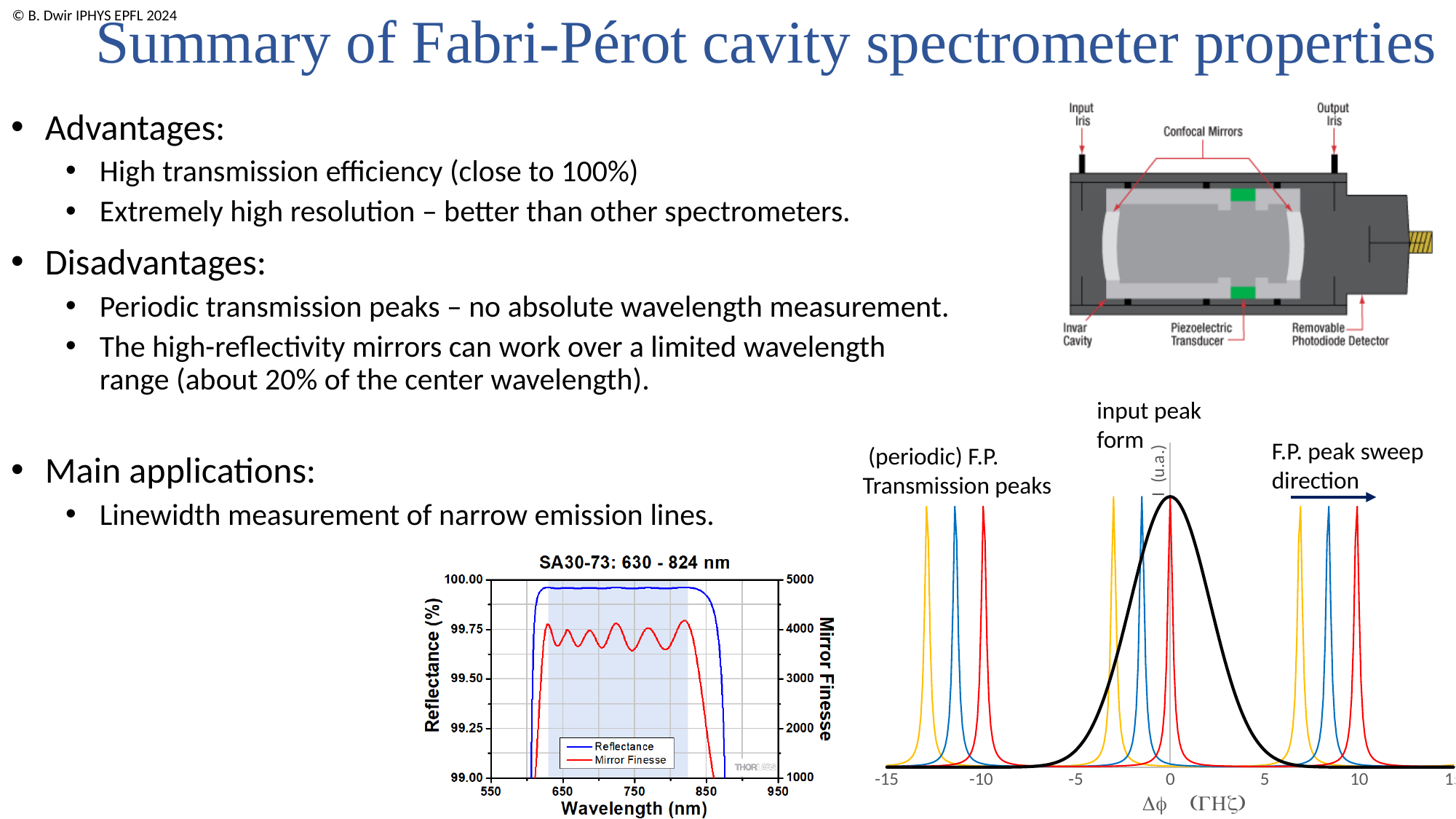
What is the x-axis label of the SA30-73: 630 - 824 nm chart? Wavelength (nm) In the SA30-73: 630 - 824 nm chart, is the reflectance at 900 nm greater or less than 99.25%? less What are the two legend entries in the SA30-73: 630 - 824 nm chart? Reflectance and Mirror Finesse In the periodic F.P. transmission peaks chart on the right, what is the lowest Δφ tick shown on the x axis? -15 In the periodic F.P. transmission peaks chart on the right, how many red peaks are shown? 3 What kind of chart is the SA30-73: 630 - 824 nm chart? line chart In the SA30-73: 630 - 824 nm chart, is the reflectance at 750 nm greater or less than 99.75%? greater How many series does the legend of the SA30-73: 630 - 824 nm chart list? 2 In the SA30-73: 630 - 824 nm chart, is the reflectance at 650 nm greater or less than 99.50%? greater What kind of chart is the periodic F.P. transmission peaks chart on the right of the slide? line chart In the chart of periodic F.P. transmission peaks on the right, at what value of Δφ does the black input peak reach its maximum? 0